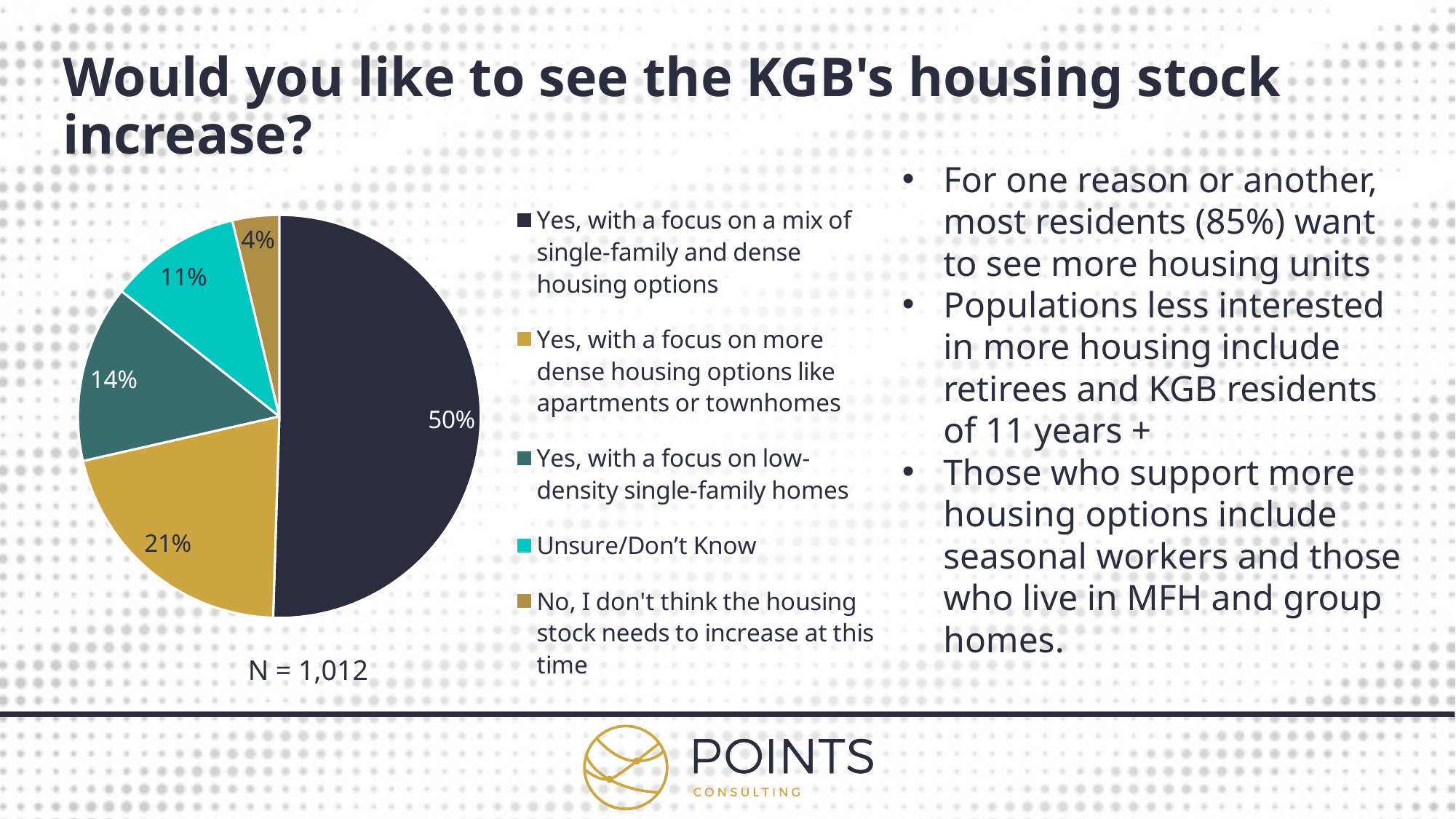
What sample size (N) is shown below the pie chart? N = 1,012 What share of respondents answered "Yes, with a focus on more dense housing options like apartments or townhomes"? 21% What share of respondents answered "Yes, with a focus on a mix of single-family and dense housing options"? 50% How many slices does the pie chart have? 5 Which is larger: the "Unsure/Don't Know" slice or the "Yes, with a focus on low-density single-family homes" slice? Yes, with a focus on low-density single-family homes What share of respondents answered "Yes, with a focus on low-density single-family homes"? 14% Which response has the largest slice of the pie? Yes, with a focus on a mix of single-family and dense housing options What share of respondents answered "No, I don't think the housing stock needs to increase at this time"? 4% Which response has the smallest slice of the pie? No, I don't think the housing stock needs to increase at this time What share of respondents answered "Unsure/Don't Know"? 11% What is the difference in percentage points between the "Yes, with a focus on more dense housing options" slice and the "Yes, with a focus on low-density single-family homes" slice? 7 percentage points What type of chart is shown on the slide? Pie chart